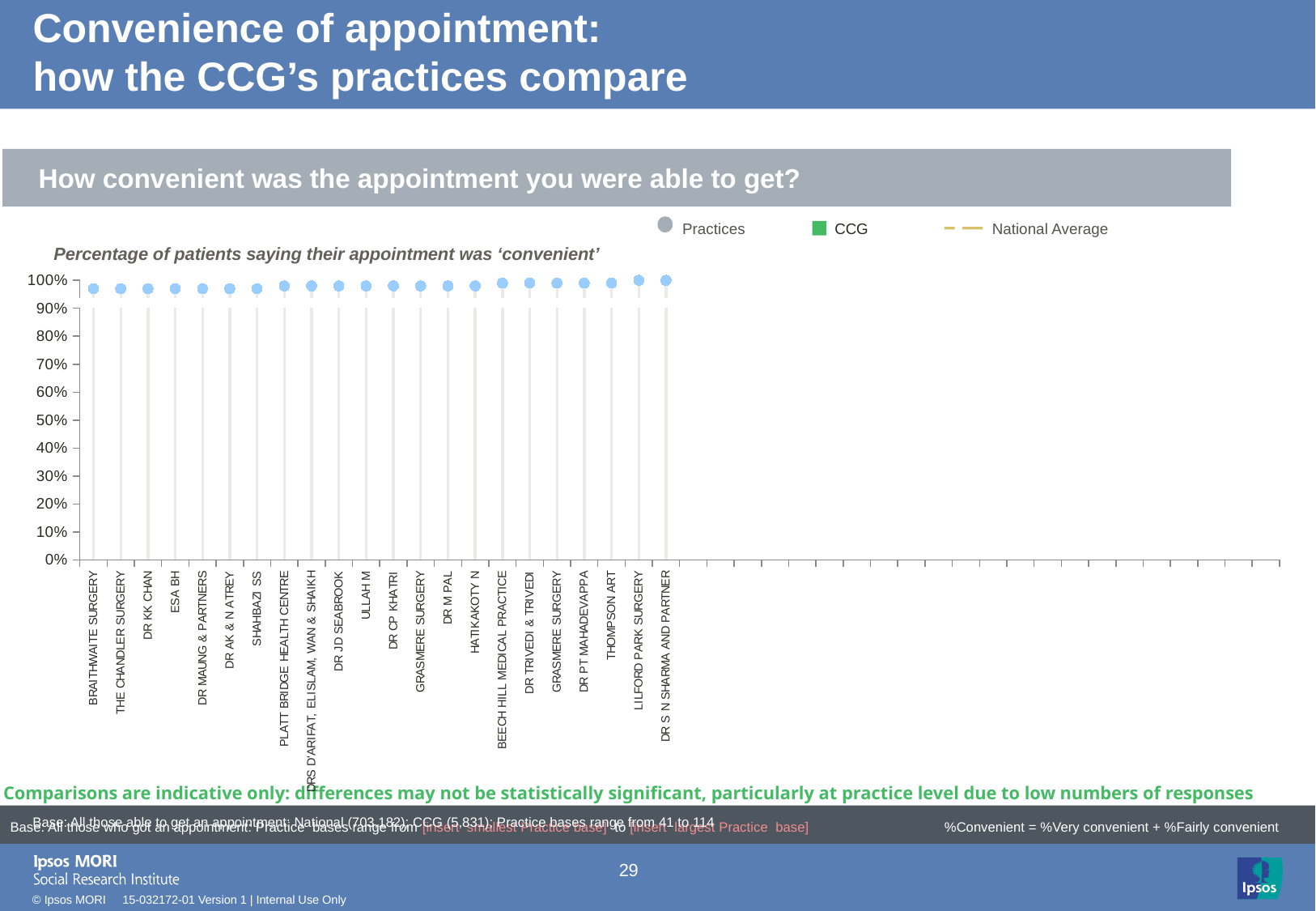
What is the subtitle printed above the chart describing what is plotted? Percentage of patients saying their appointment was 'convenient' Which practice is plotted first (leftmost) on the x axis? BRAITHWAITE SURGERY Do the plotted values rise or fall moving from left to right along the x axis? rise Is the value for DR S N SHARMA AND PARTNER greater or less than 90%? greater What are the three entries in the chart legend? Practices, CCG, National Average How many series does the legend list? 3 Is the value for ULLAH M greater or less than 50%? greater What is the highest value shown on the y axis? 100% Is the value for THOMPSON ART greater or less than 80%? greater How many practices are plotted along the x axis? 22 Which practice is plotted last (rightmost) on the x axis? DR S N SHARMA AND PARTNER